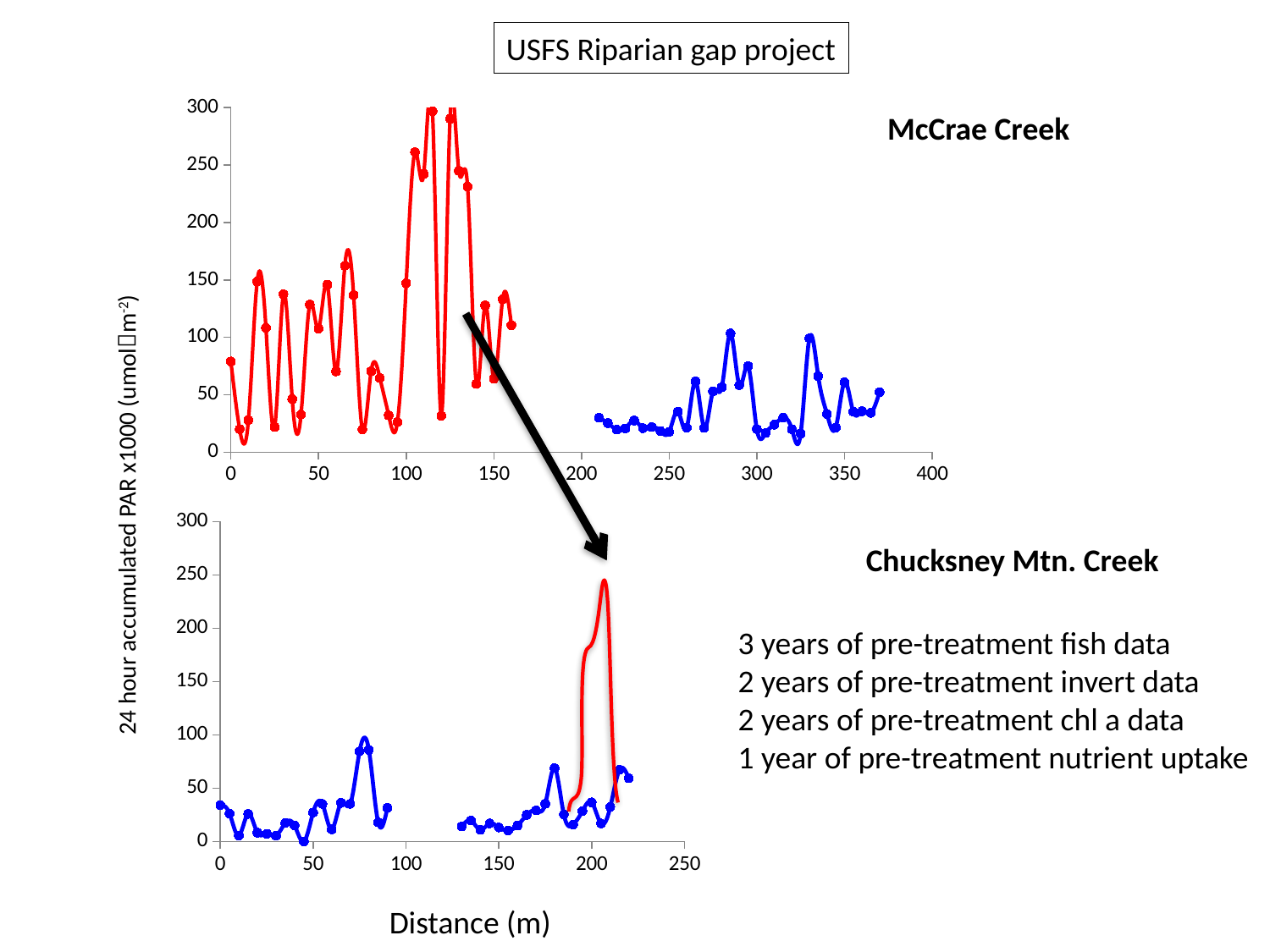
What is the x-axis label shared by the charts? Distance (m) Which chart reaches a higher peak value, McCrae Creek or Chucksney Mtn. Creek? McCrae Creek What kind of chart is the Chucksney Mtn. Creek chart? line chart What kind of chart is the McCrae Creek chart? line chart How many charts are shown on the slide? 2 In the Chucksney Mtn. Creek chart, is the highest value of the blue line greater or less than 150? less In the McCrae Creek chart, is the highest value of the blue line greater or less than 150? less In the Chucksney Mtn. Creek chart, is the peak of the red line greater or less than 200? greater In the McCrae Creek chart, which line reaches a higher peak value, the red line or the blue line? the red line What is the maximum value shown on the y-axis of the McCrae Creek chart? 300